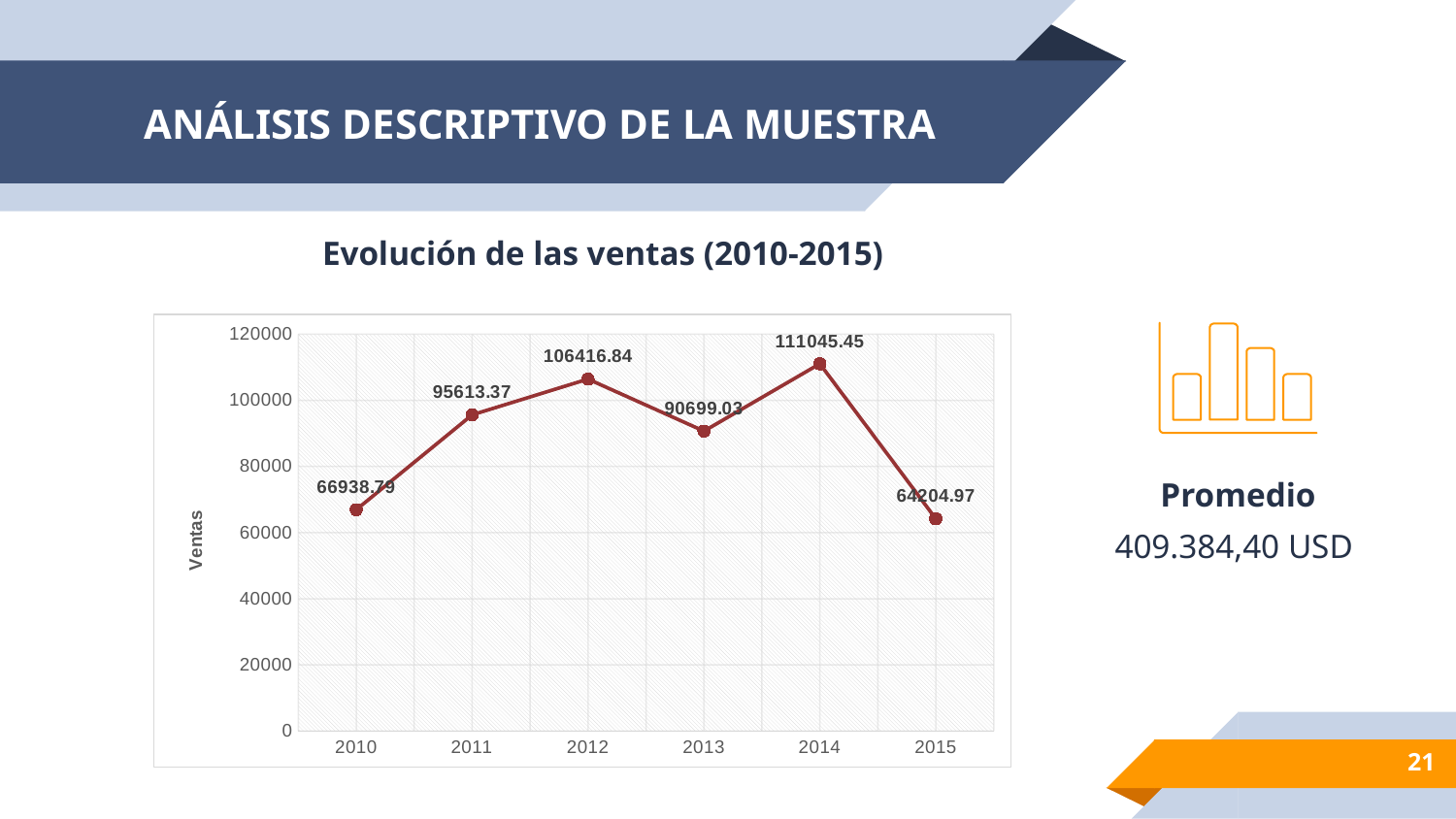
How many years are plotted on the chart? 6 What is the difference between the sales values for 2014 and 2010? 44106.66 What is the sales value for 2012? 106416.84 What is the title of the chart? Evolución de las ventas (2010-2015) What is the sales value for 2010? 66938.79 What type of chart is shown on the slide? Line chart Is the sales value for 2013 greater or less than 100000? less Which year has a larger sales value, 2011 or 2013? 2011 Which year has the highest sales value? 2014 What is the difference between the sales values for 2012 and 2011? 10803.47 Which year has the lowest sales value? 2015 What is the sales value for 2015? 64204.97